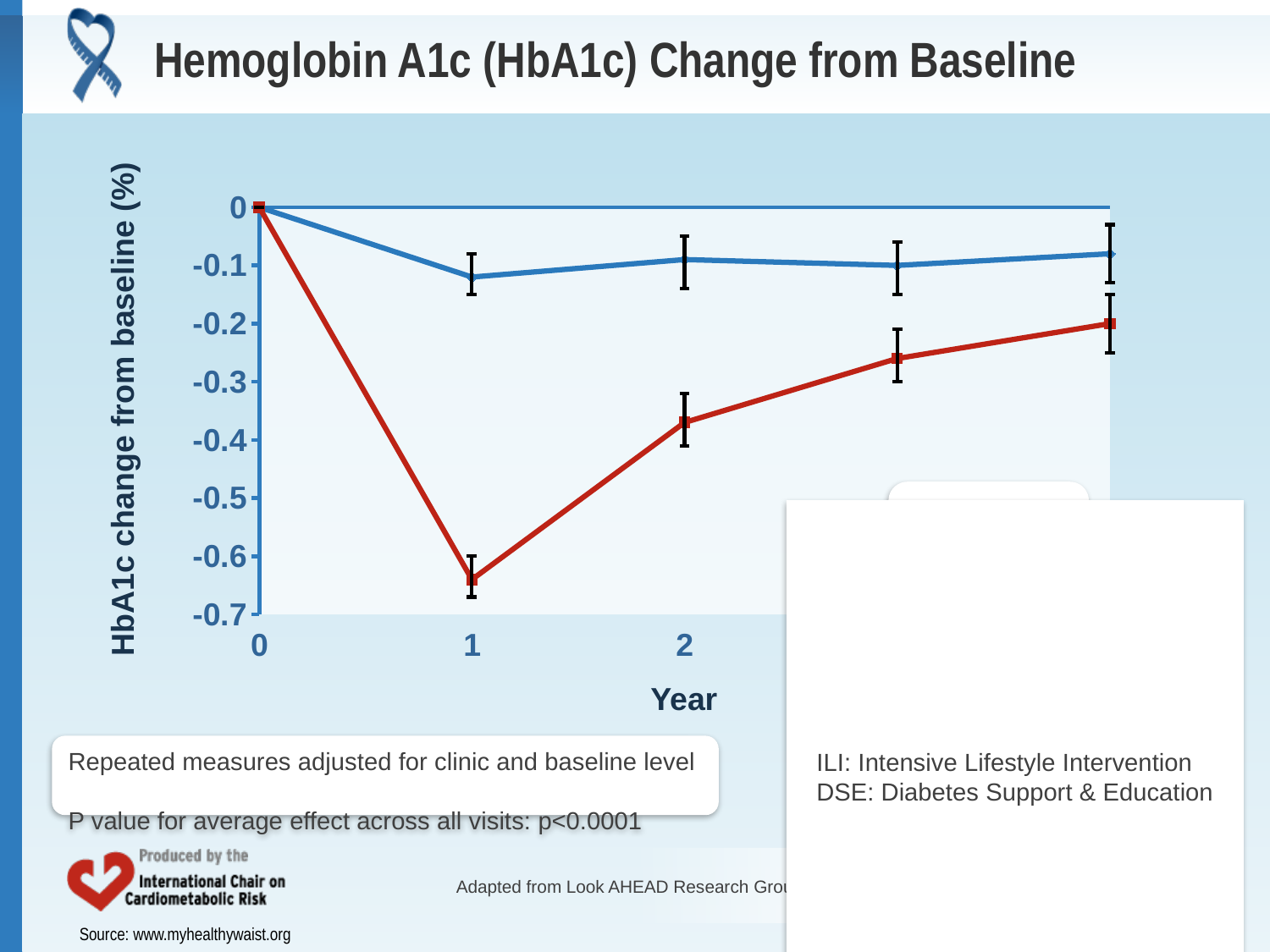
What kind of chart is shown on the slide? line chart Is the value of the red line at year 1 greater or less than -0.6? less What is the label of the vertical axis? HbA1c change from baseline (%) Is the value of the red line at year 2 greater or less than -0.3? less What is the value of the red line at year 0? 0 At which year does the red line reach its lowest value? 1 Is the value of the blue line at year 1 greater or less than -0.2? greater At year 1, which line shows the larger decrease from baseline, the red line or the blue line? the red line Does the red line rise or fall between year 1 and year 2? rise What is the title of the chart? Hemoglobin A1c (HbA1c) Change from Baseline Does the red line rise or fall between year 0 and year 1? fall